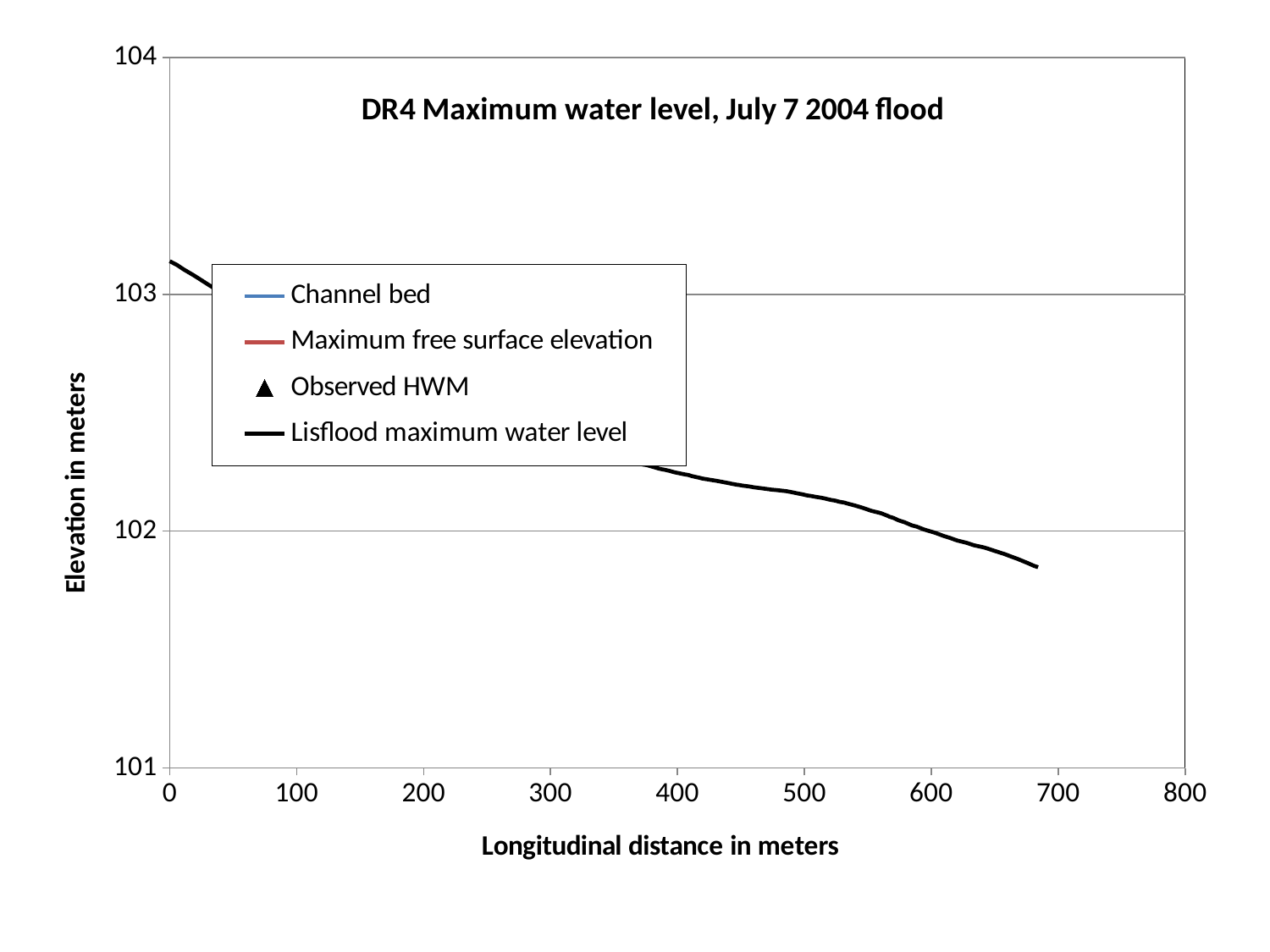
Is the Lisflood maximum water level at a longitudinal distance of 0 meters greater or less than 104? less How many series does the legend list? 4 What is the label of the vertical axis? Elevation in meters What kind of chart is shown on the slide? line chart Does the Lisflood maximum water level rise or fall as longitudinal distance increases? fall Is the Lisflood maximum water level at the right end of the plotted line (near 680 meters) greater or less than 102? less What is the title of the chart? DR4 Maximum water level, July 7 2004 flood Is the Lisflood maximum water level at a longitudinal distance of 0 meters greater or less than 103? greater Which is larger, the Lisflood maximum water level at 0 meters or at 600 meters? at 0 meters